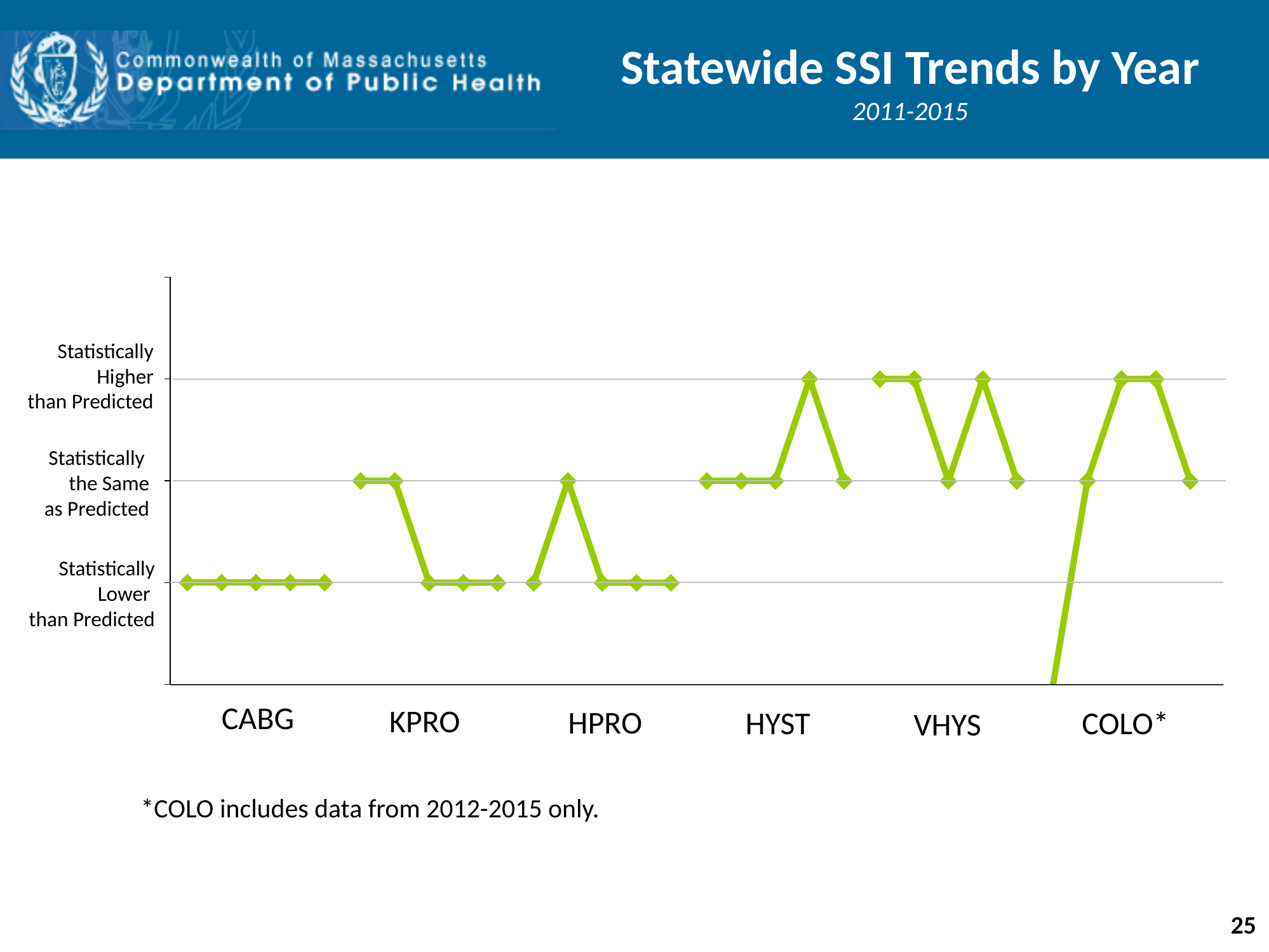
At which level is the fourth HYST point plotted? Statistically Higher than Predicted What kind of chart is shown on the slide? line chart Do the KPRO points rise or fall from the first point to the last point? fall What is the title of the chart on the slide? Statewide SSI Trends by Year How many data points are plotted for CABG? 5 At which level is the first KPRO point plotted? Statistically the Same as Predicted How many procedure categories are shown along the x axis of the chart? 6 Which procedure category has every one of its points at the Statistically Lower than Predicted level? CABG According to the footnote, which years of data does COLO include? 2012-2015 At which level are all of the CABG points plotted? Statistically Lower than Predicted At which level is the last VHYS point plotted? Statistically the Same as Predicted How many data points are plotted for COLO*? 4